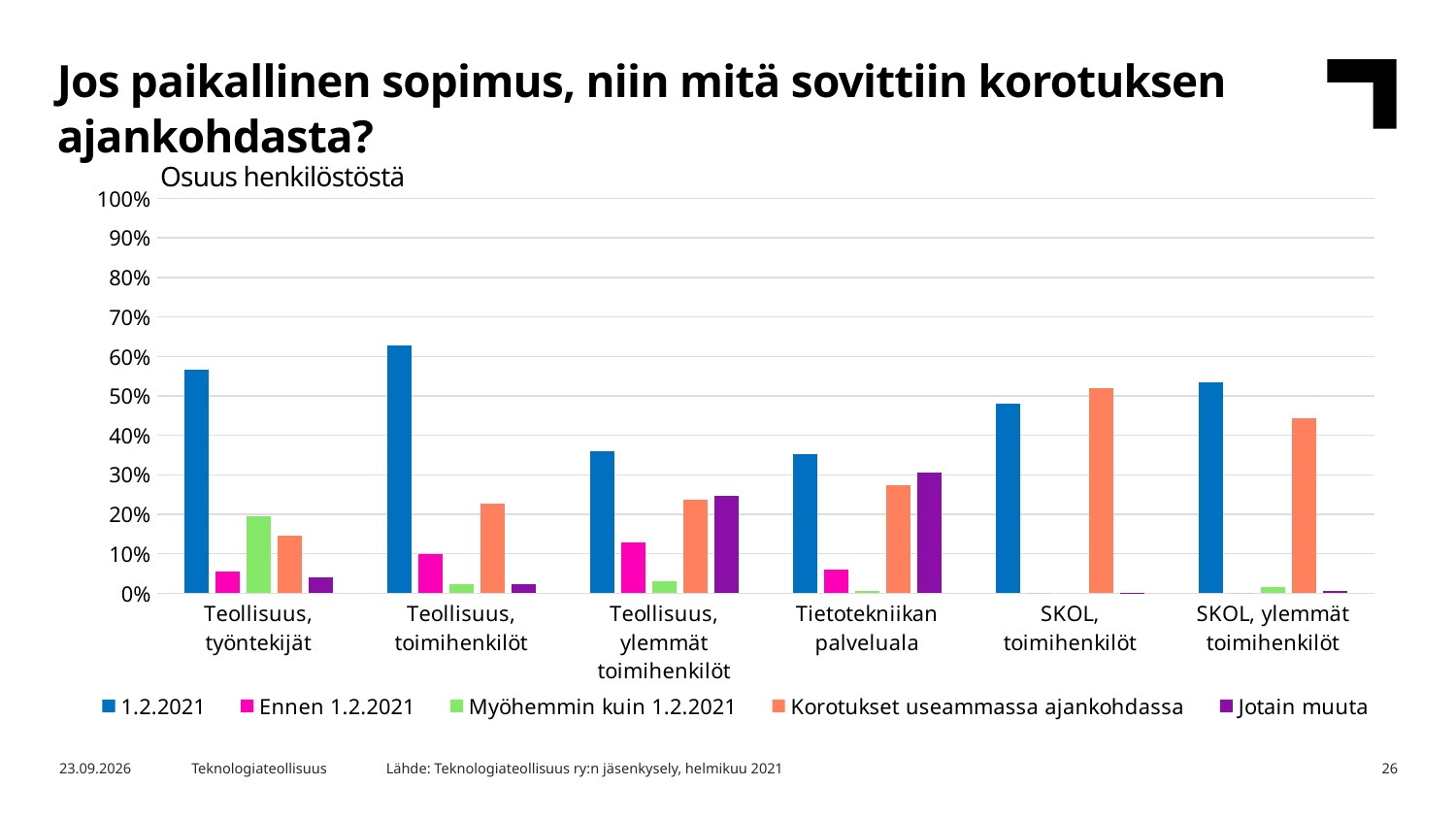
How many categories are shown on the x axis? 6 What kind of chart is shown on the slide? Bar chart What label is shown above the vertical axis of the chart? Osuus henkilöstöstä Is the value for Ennen 1.2.2021 in the category Teollisuus, ylemmät toimihenkilöt greater or less than 10%? greater Is the value for Jotain muuta in the category Tietotekniikan palveluala greater or less than 20%? greater Which category has the highest value for the series 1.2.2021? Teollisuus, toimihenkilöt In the category SKOL, toimihenkilöt, which is larger: 1.2.2021 or Korotukset useammassa ajankohdassa? Korotukset useammassa ajankohdassa In the category Teollisuus, työntekijät, which is larger: Myöhemmin kuin 1.2.2021 or Korotukset useammassa ajankohdassa? Myöhemmin kuin 1.2.2021 Is the value for Korotukset useammassa ajankohdassa in the category SKOL, toimihenkilöt greater or less than 40%? greater How many series does the legend list? 5 Which category has the highest value for the series Jotain muuta? Tietotekniikan palveluala